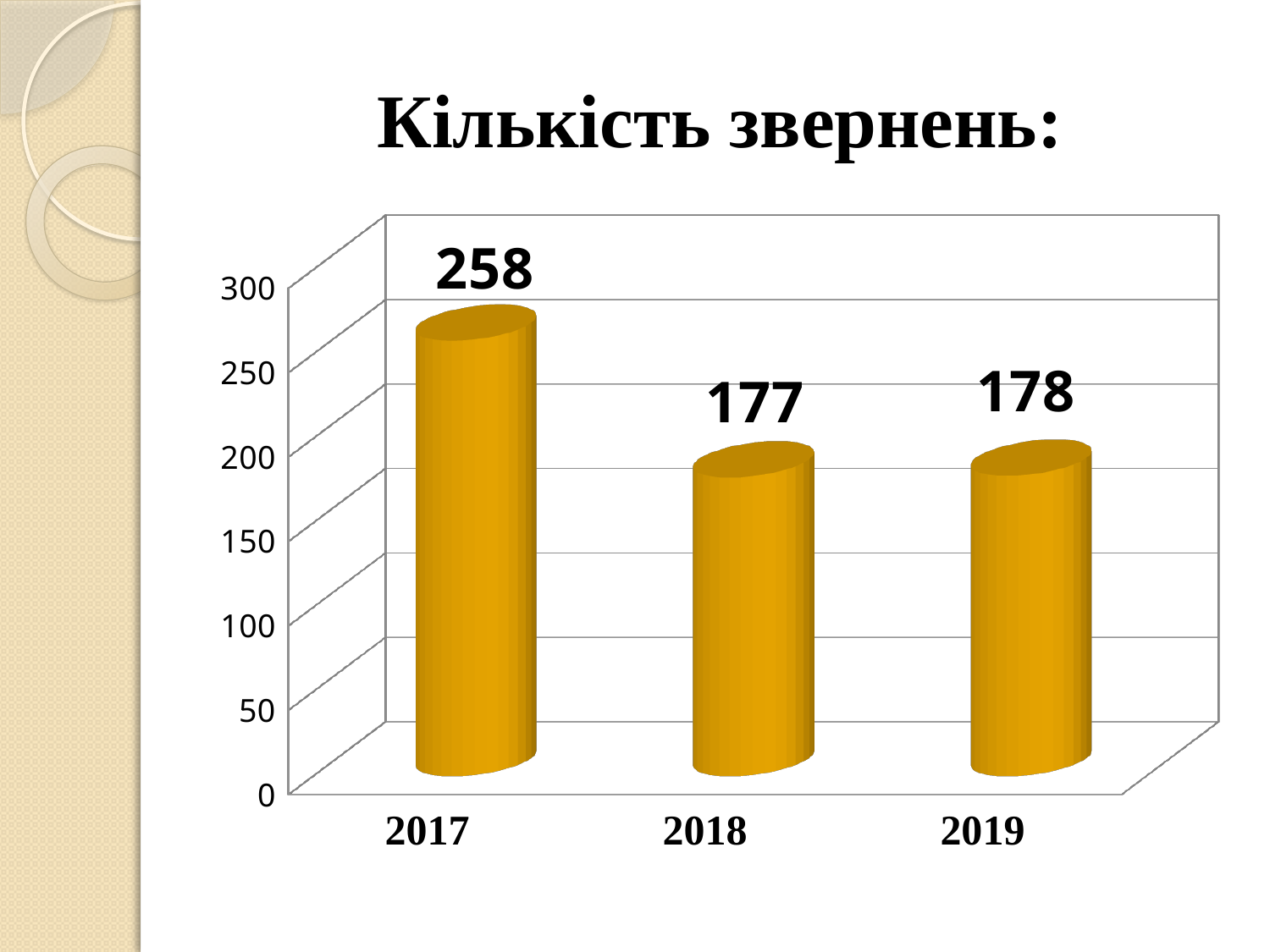
What is the value for 2017? 258 What is the value for 2018? 177 Which year has the lowest value? 2018 What is the difference between the values for 2019 and 2018? 1 What is the value for 2019? 178 Which year has the highest value? 2017 Which is larger, the value for 2017 or the value for 2019? 2017 How many years are shown on the x axis? 3 What kind of chart is shown on the slide? bar chart What is the difference between the values for 2017 and 2018? 81 Is the value for 2017 greater or less than 250? greater What is the title of the chart? Кількість звернень: